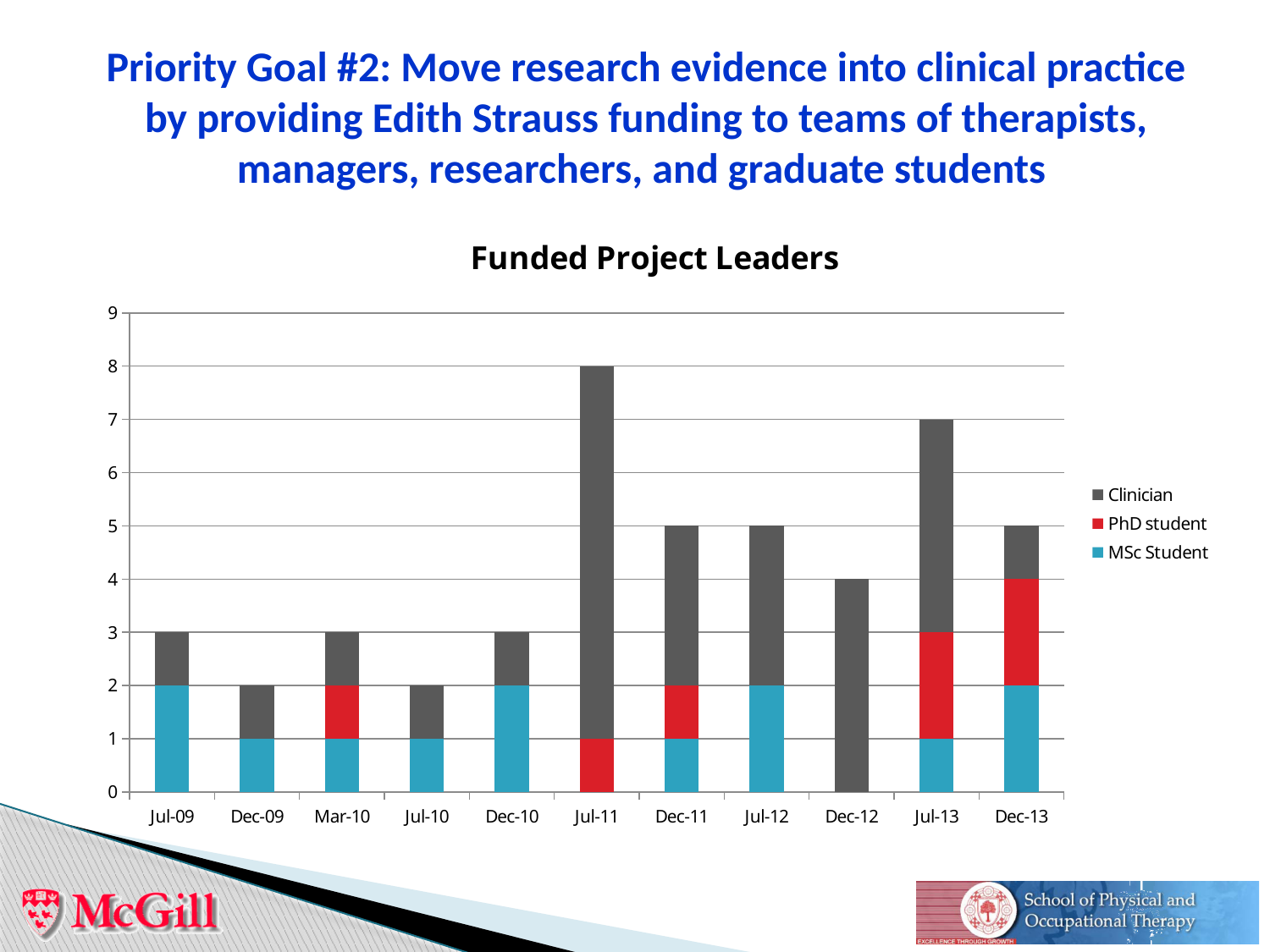
What is the total height of the stacked bar for Jul-13? 7 Which colour represents the Clinician series in the legend? Grey Is the total for Jul-11 greater or less than 6? greater Which period has the tallest stacked bar in the Funded Project Leaders chart? Jul-11 What is the difference between the total for Jul-11 and the total for Dec-12? 4 What is the MSc Student value for Jul-09? 2 How many series does the legend of the Funded Project Leaders chart list? 3 How many time periods are shown on the x axis of the Funded Project Leaders chart? 11 What is the MSc Student value for Dec-13? 2 Which stacked bar is taller, Dec-11 or Dec-12? Dec-11 What is the total height of the stacked bar for Jul-11? 8 What kind of chart is shown under the title "Funded Project Leaders"? Stacked bar chart